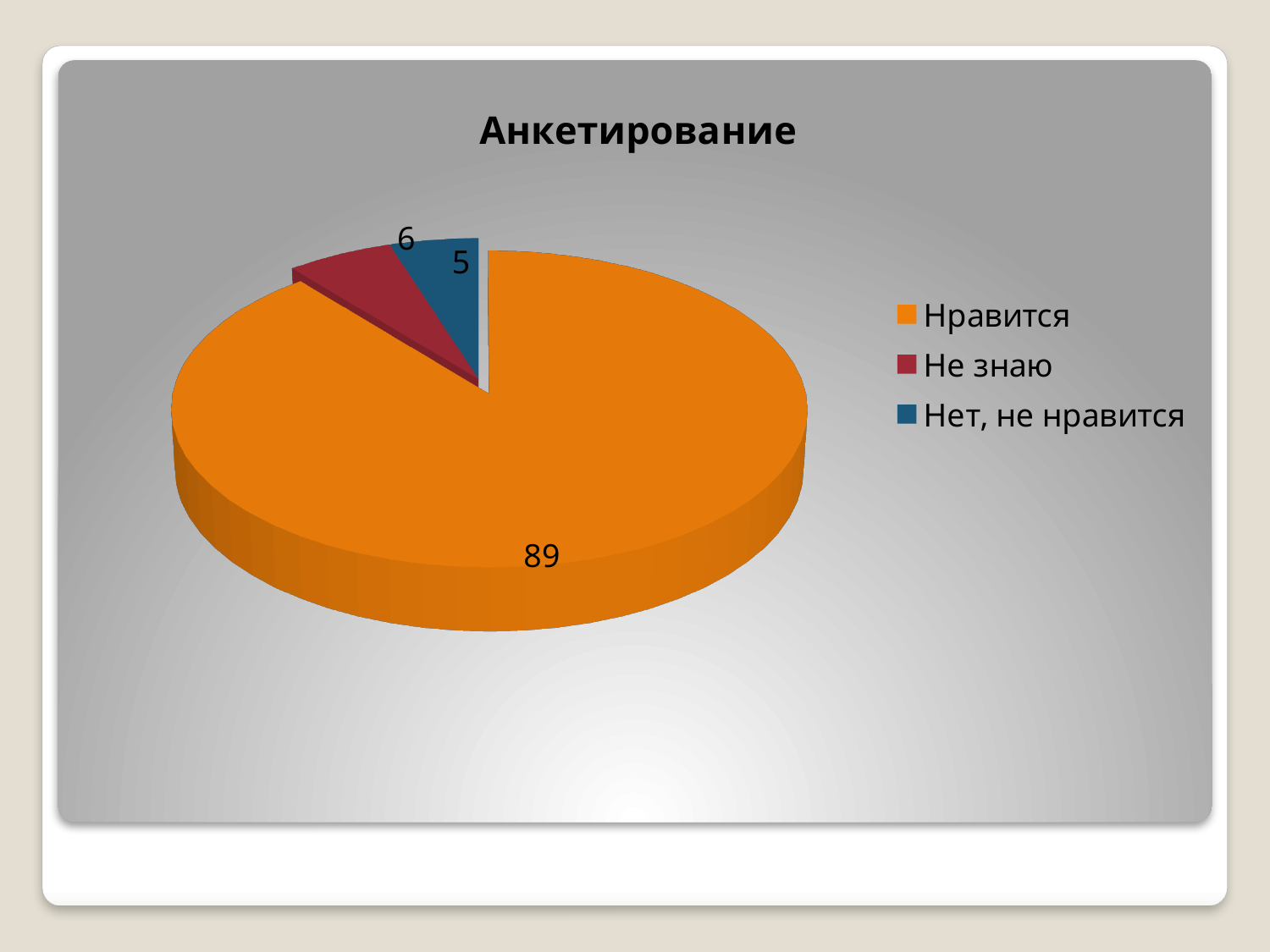
Which category has the largest slice? Нравится What is the difference between the values for "Нравится" and "Не знаю"? 83 What type of chart is shown on the slide? Pie chart What is the value for "Нет, не нравится"? 5 How many categories does the pie chart have? 3 What is the total of all slices in the pie chart? 100 Which category has the smallest slice? Нет, не нравится What is the difference between the values for "Не знаю" and "Нет, не нравится"? 1 What is the title of the chart? Анкетирование What is the value for "Не знаю"? 6 What is the value for "Нравится"? 89 What share of the pie does "Нравится" represent? 89%